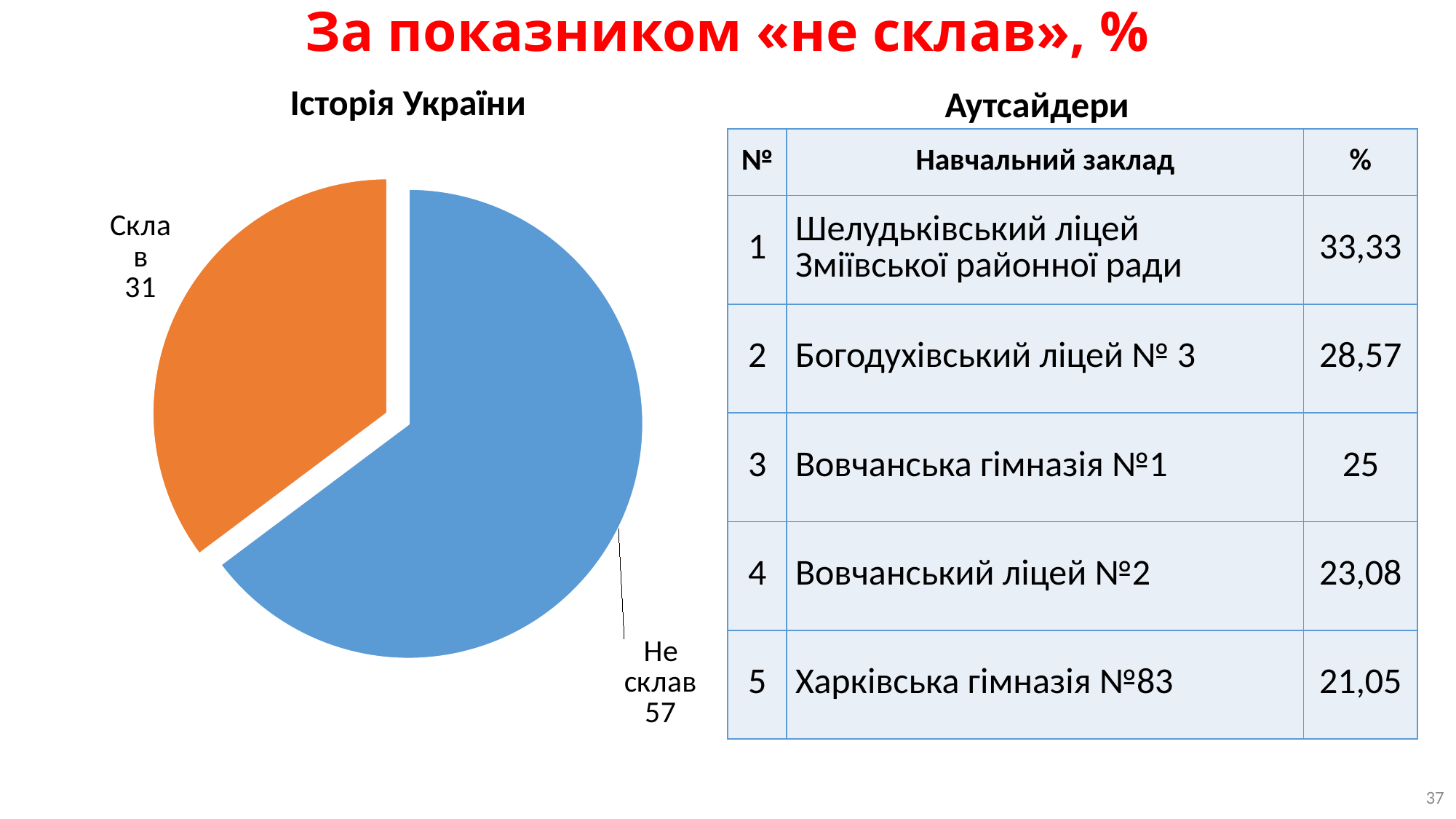
In the "Історія України" pie chart, what is the value for "Склав"? 31 In the "Історія України" pie chart, what colour is the "Не склав" slice? blue In the "Історія України" pie chart, which is larger: "Склав" or "Не склав"? Не склав In the "Історія України" pie chart, which slice is the smallest? Склав In the "Історія України" pie chart, what is the difference between the "Не склав" and "Склав" values? 26 In the "Історія України" pie chart, what is the value for "Не склав"? 57 What is the title of the pie chart on the slide? Історія України What is the total of the two slice values in the "Історія України" pie chart? 88 How many slices does the "Історія України" pie chart have? 2 What type of chart is shown under the heading "Історія України"? pie chart In the "Історія України" pie chart, which slice is the largest? Не склав